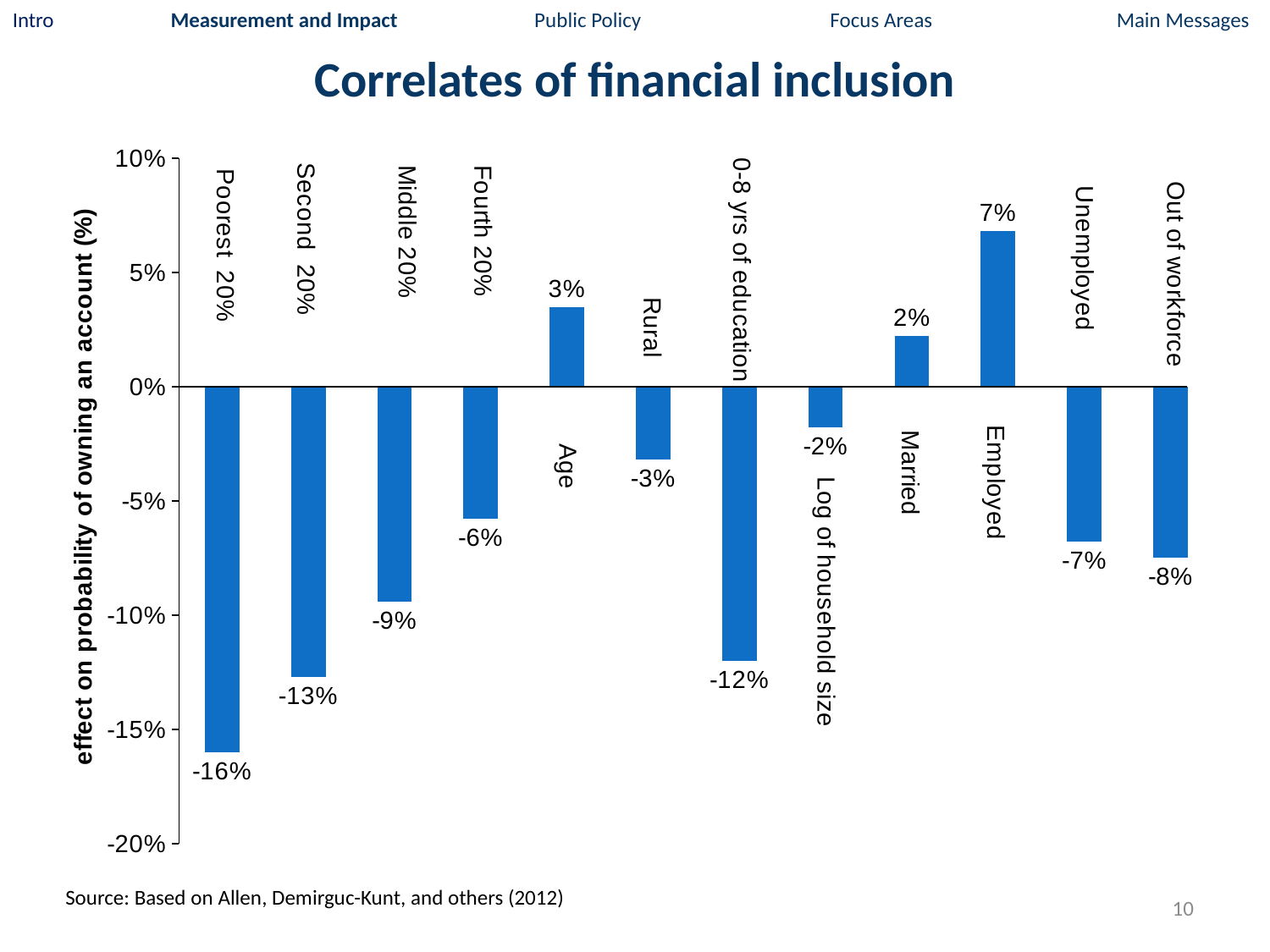
How many categories are shown in the chart? 12 Which is larger, the value for Age or the value for Married? Age What is the difference between the values for Employed and Married? 5% What is the value for Out of workforce? -8% What kind of chart is shown on the slide? Bar chart Which category has the lowest value? Poorest 20% What is the value for 0-8 yrs of education? -12% What is the title of the chart? Correlates of financial inclusion What is the value for Employed? 7% Which category has the highest value? Employed What is the label of the vertical axis? effect on probability of owning an account (%) What is the value for Poorest 20%? -16%